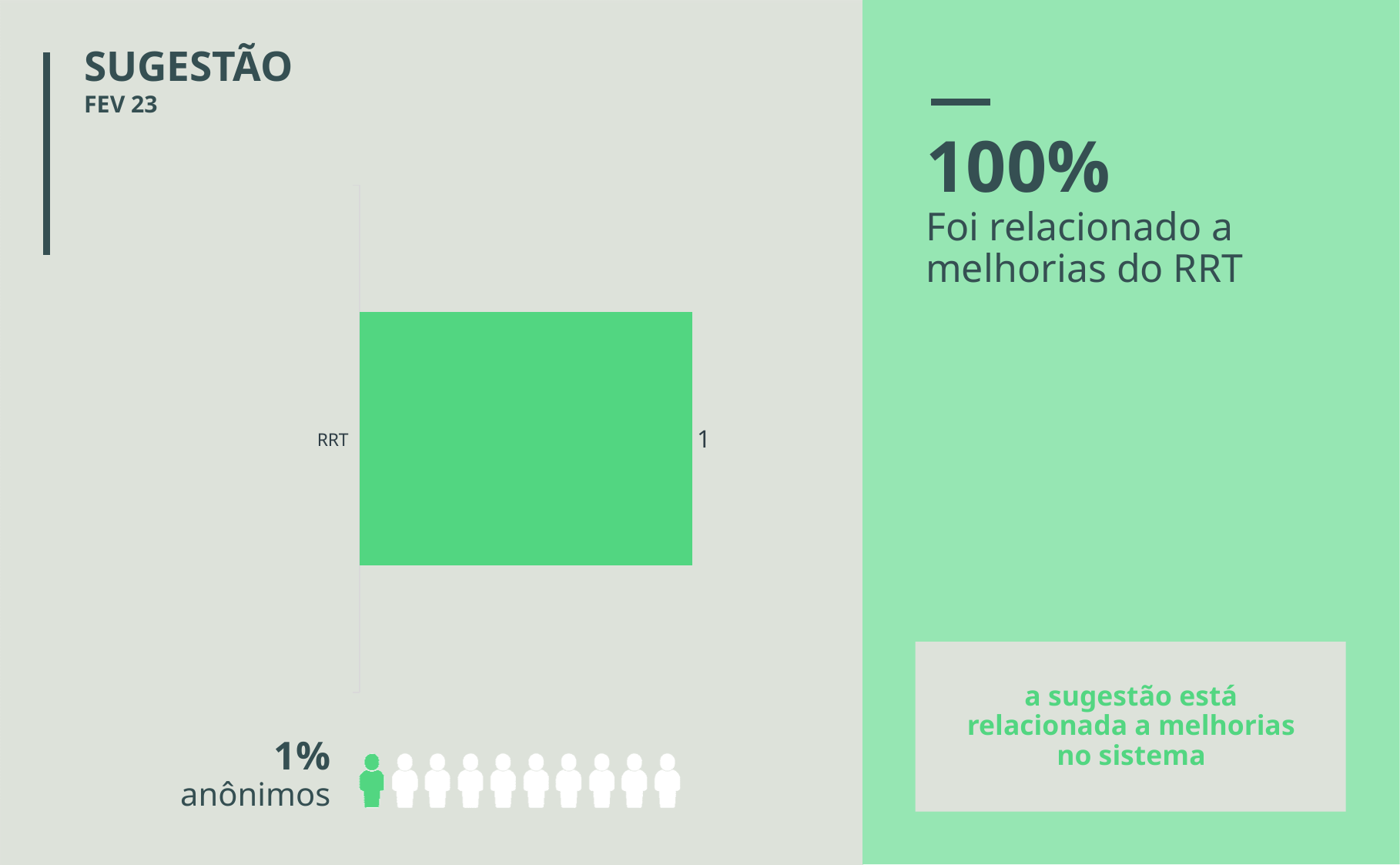
What is the value for RRT in the bar chart? 1 Is the bar in the chart horizontal or vertical? horizontal What kind of chart is shown on the slide? bar chart What colour is the bar in the chart? green What is the label of the only category in the bar chart? RRT How many categories does the bar chart show? 1